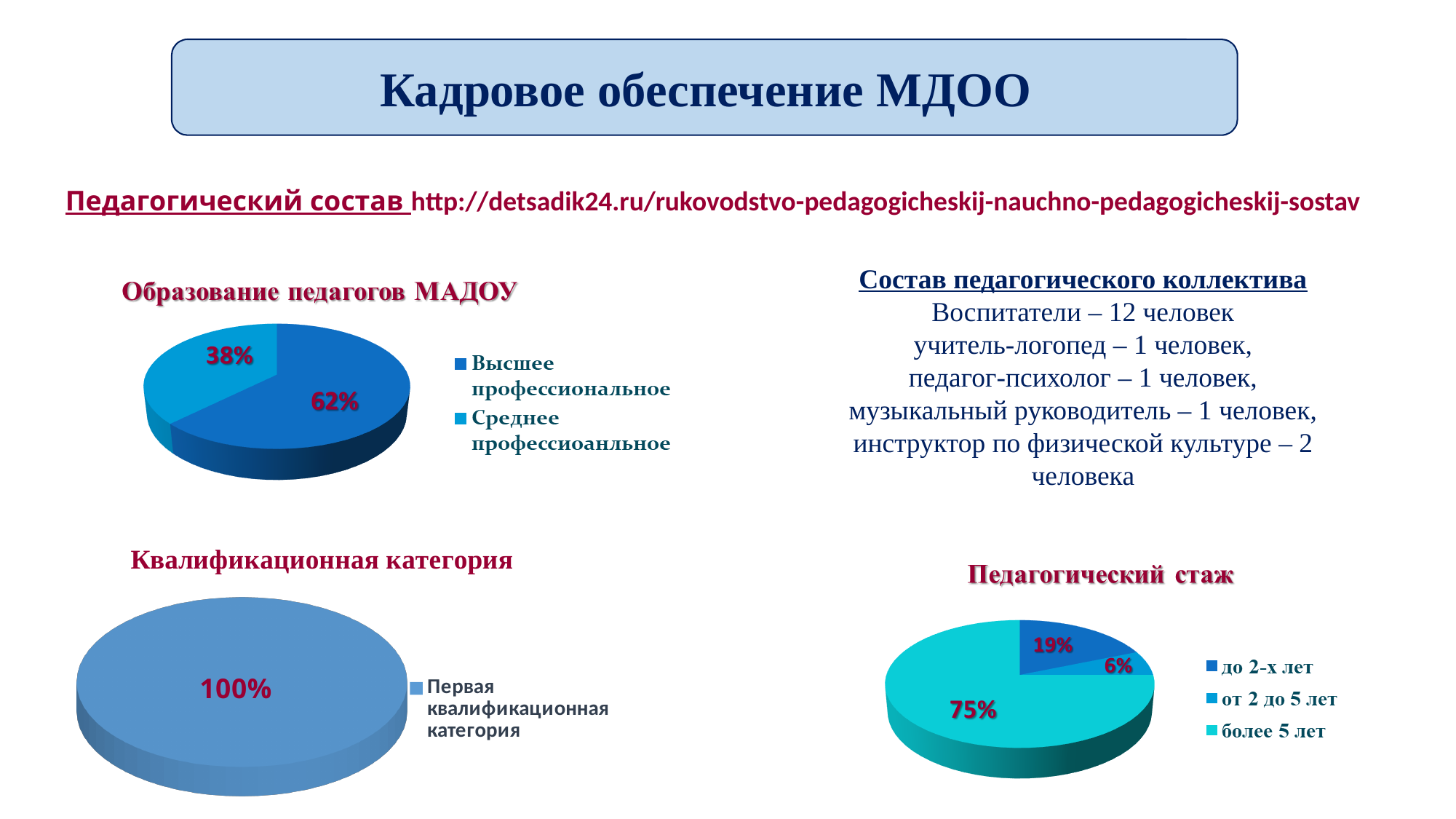
In the 'Квалификационная категория' chart, what share is shown for 'Первая квалификационная категория'? 100% In the 'Педагогический стаж' chart, which category has the smallest share? от 2 до 5 лет How many categories does the legend of the 'Квалификационная категория' chart list? 1 In the 'Образование педагогов МАДОУ' chart, what share of teachers have 'Высшее профессиональное' education? 62% What kind of chart is the 'Квалификационная категория' chart? Pie chart In the 'Педагогический стаж' chart, what is the difference between the 'до 2-х лет' and 'от 2 до 5 лет' shares? 13% In the 'Педагогический стаж' chart, what share of teachers have 'до 2-х лет' of experience? 19% In the 'Образование педагогов МАДОУ' chart, what is the difference between the 'Высшее профессиональное' and 'Среднее профессиоанльное' shares? 24% In the 'Образование педагогов МАДОУ' chart, which category has the larger share? Высшее профессиональное In the 'Педагогический стаж' chart, what share of teachers have 'более 5 лет' of experience? 75% In the 'Образование педагогов МАДОУ' chart, what share of teachers have 'Среднее профессиоанльное' education? 38% How many categories does the 'Педагогический стаж' chart have? 3